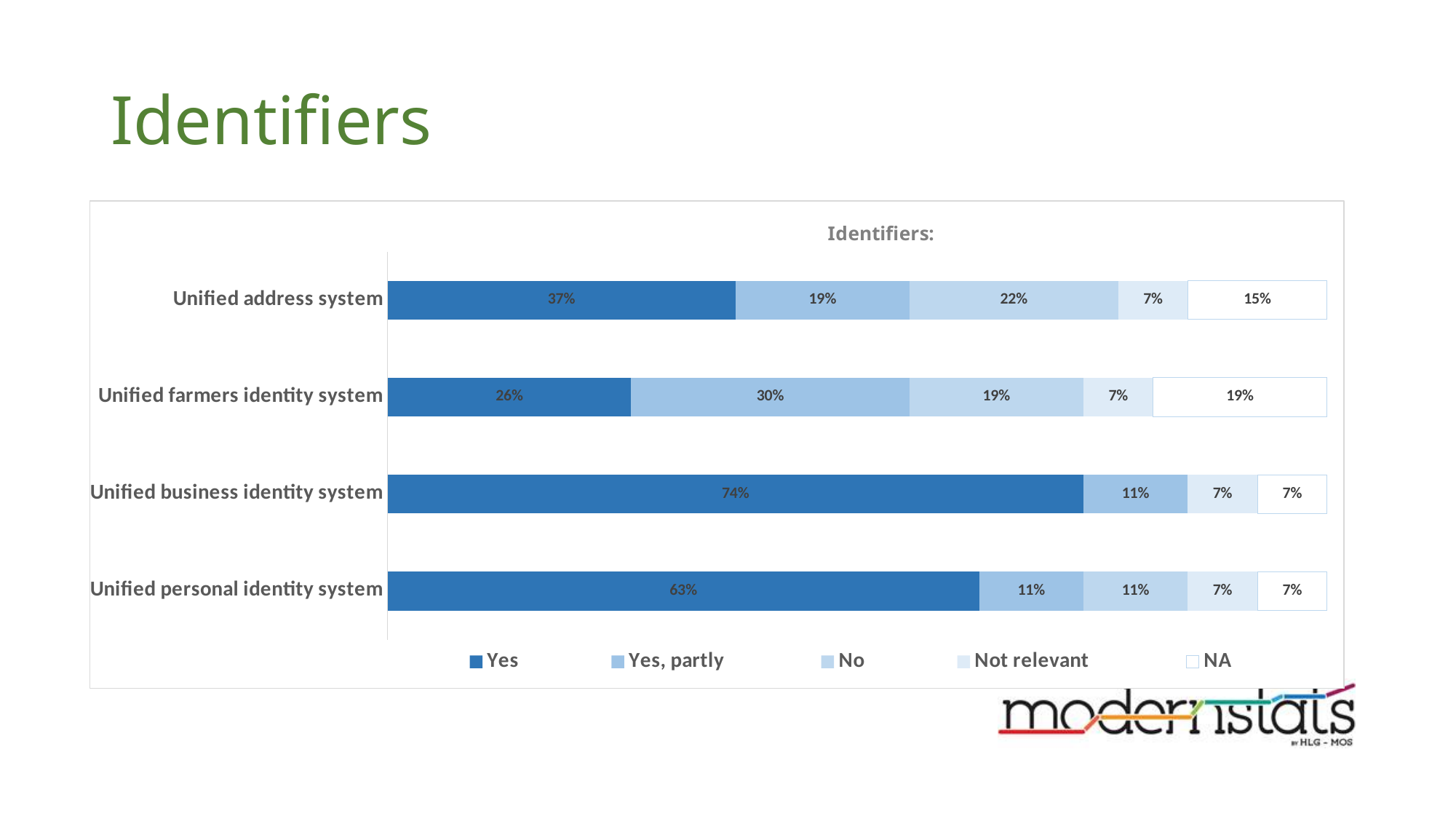
How many series does the legend list? 5 What is the "Yes" value for Unified business identity system? 74% What kind of chart is shown on the slide? Stacked bar chart What is the total of the stacked bar for Unified address system? 100% What is the "NA" value for Unified address system? 15% What is the "No" value for Unified address system? 22% Which has a larger "Yes" value: Unified address system or Unified farmers identity system? Unified address system Which category has the highest "Yes" value? Unified business identity system What is the "Yes, partly" value for Unified farmers identity system? 30% Which category has the lowest "Yes" value? Unified farmers identity system How many categories are shown on the chart? 4 What is the difference between the "Yes" values for Unified business identity system and Unified personal identity system? 11 percentage points